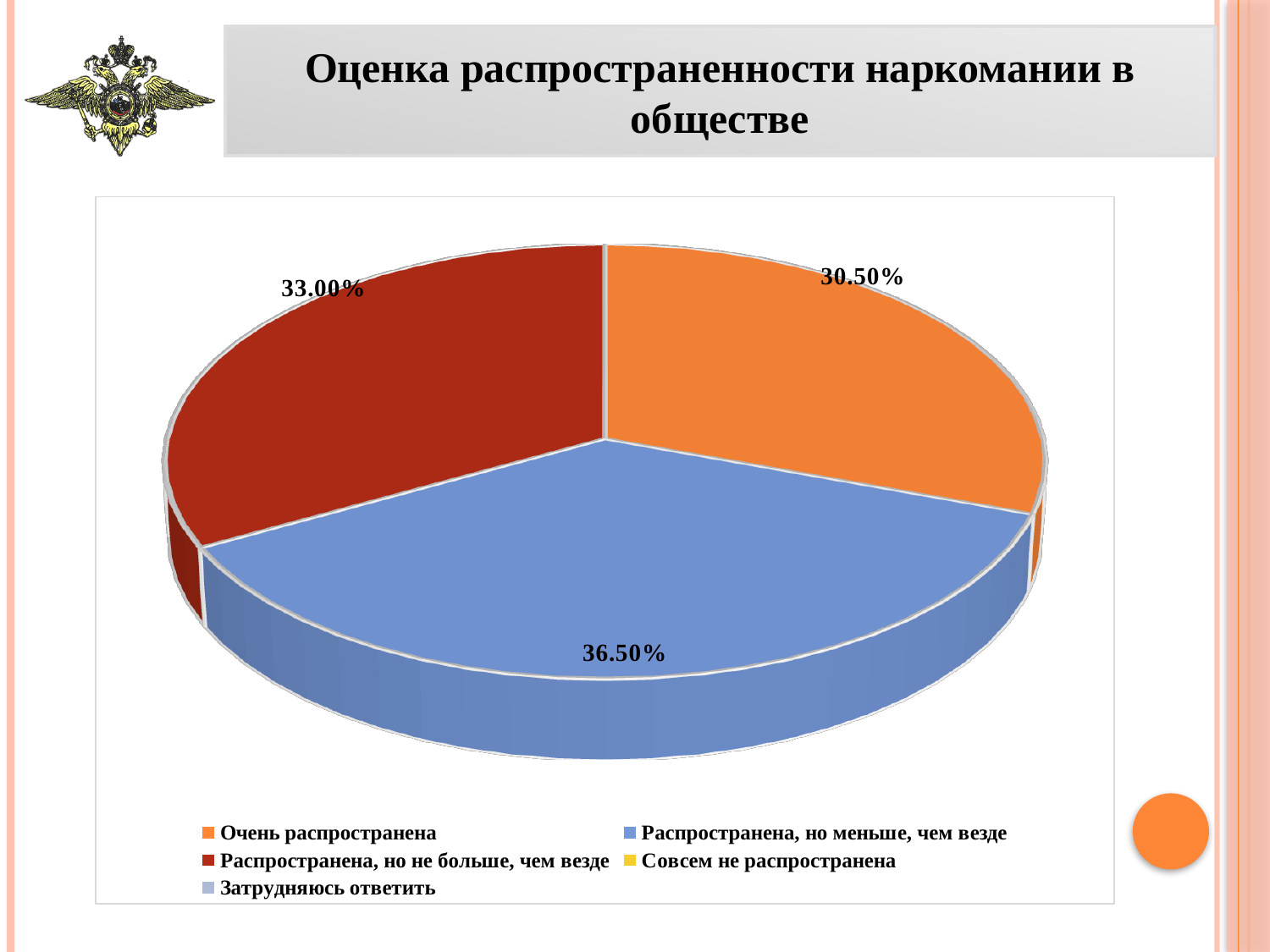
Which category has the largest slice of the pie? Распространена, но меньше, чем везде What percentage is shown for the slice "Распространена, но меньше, чем везде"? 36.50% What kind of chart is shown on the slide? pie chart What percentage is shown for the slice "Распространена, но не больше, чем везде"? 33.00% Which slice is larger: "Распространена, но не больше, чем везде" or "Очень распространена"? Распространена, но не больше, чем везде What is the difference in percentage points between the "Распространена, но меньше, чем везде" slice and the "Очень распространена" slice? 6 percentage points How many entries does the legend list? 5 Which of the labelled slices is the smallest? Очень распространена What is the title of the chart on the slide? Оценка распространенности наркомании в обществе What colour is the slice for "Очень распространена"? orange What percentage is shown for the slice "Очень распространена"? 30.50% How many slices with data labels are visible in the pie? 3